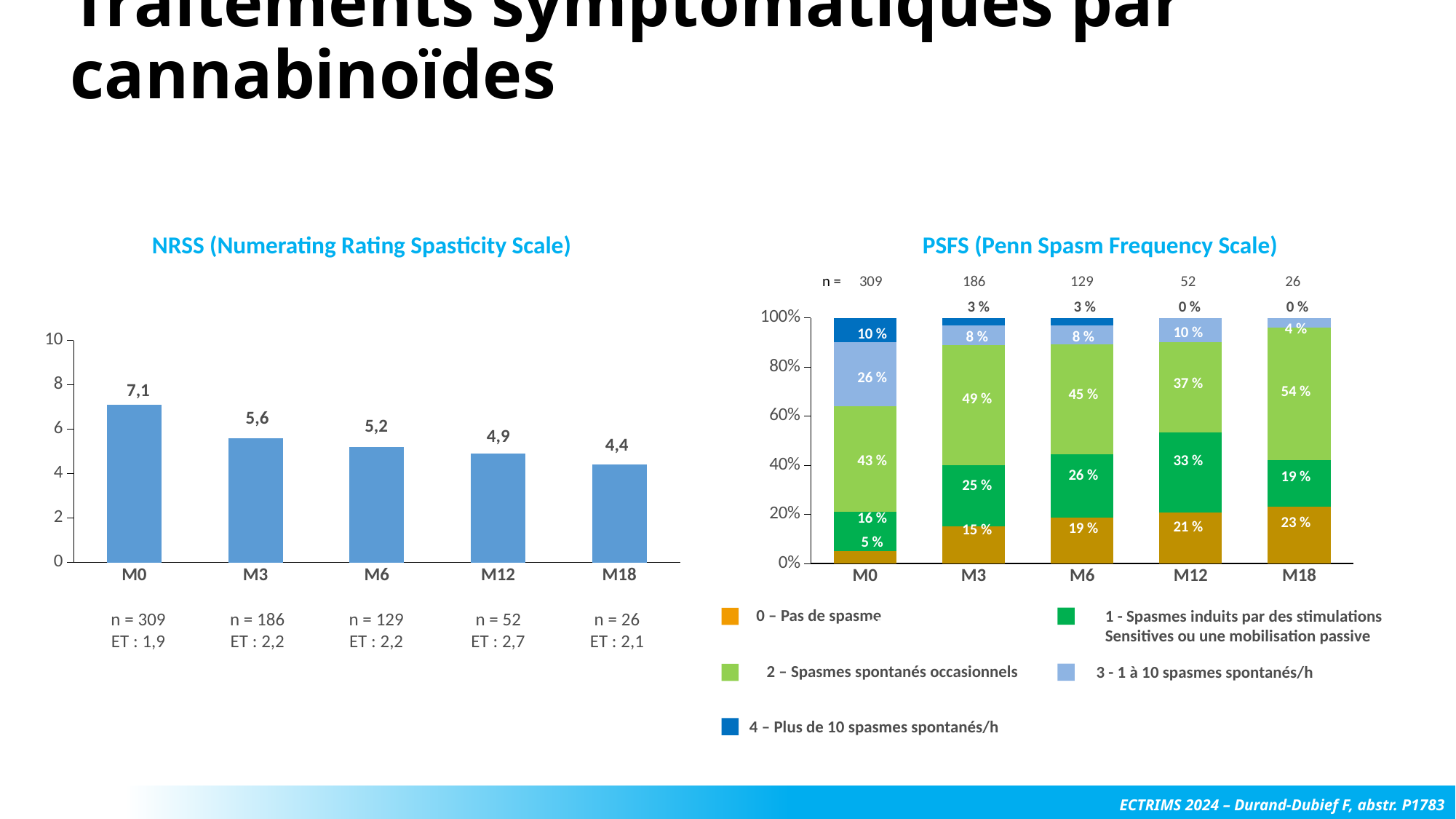
In the PSFS (Penn Spasm Frequency Scale) chart, what is the share of '4 – Plus de 10 spasmes spontanés/h' at M0? 10 % In the NRSS (Numerating Rating Spasticity Scale) chart, what is the difference between the values at M0 and M18? 2,7 In the NRSS (Numerating Rating Spasticity Scale) chart, how many time points are plotted? 5 In the PSFS (Penn Spasm Frequency Scale) chart, what is the share of '0 – Pas de spasme' at M0? 5 % In the PSFS (Penn Spasm Frequency Scale) chart, which is larger at M12: the share of '1 - Spasmes induits par des stimulations' or the share of '2 – Spasmes spontanés occasionnels'? 2 – Spasmes spontanés occasionnels What kind of chart is the PSFS (Penn Spasm Frequency Scale) chart? stacked bar chart In the NRSS (Numerating Rating Spasticity Scale) chart, do the values rise or fall from M0 to M18? fall In the NRSS (Numerating Rating Spasticity Scale) chart, which time point has the highest value? M0 How many series does the legend of the PSFS (Penn Spasm Frequency Scale) chart list? 5 In the PSFS (Penn Spasm Frequency Scale) chart, what is the share of '2 – Spasmes spontanés occasionnels' at M18? 54 % In the NRSS (Numerating Rating Spasticity Scale) chart, what is the value at M0? 7,1 In the NRSS (Numerating Rating Spasticity Scale) chart, what is the value at M18? 4,4